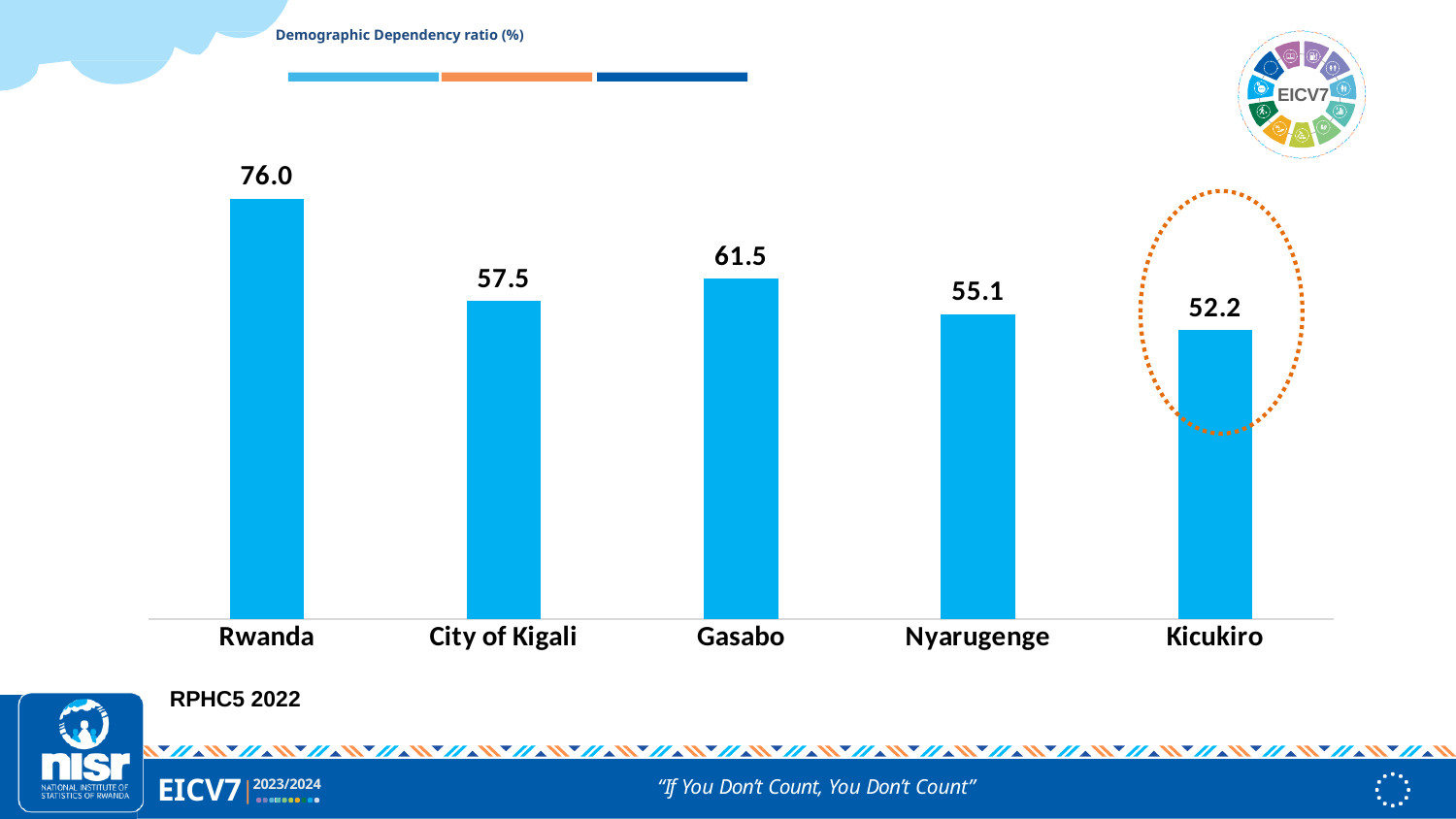
Which has a higher dependency ratio, Gasabo or Nyarugenge? Gasabo What is the demographic dependency ratio for Kicukiro? 52.2 What is the demographic dependency ratio for Nyarugenge? 55.1 What is the difference between the dependency ratio for Gasabo and for Kicukiro? 9.3 What is the difference between the dependency ratio for Rwanda and for City of Kigali? 18.5 Which category has the highest demographic dependency ratio? Rwanda Which category has the lowest demographic dependency ratio? Kicukiro What is the demographic dependency ratio for City of Kigali? 57.5 What is the demographic dependency ratio for Rwanda? 76.0 How many categories are shown in the chart? 5 What kind of chart is shown on the slide? Bar chart What is the demographic dependency ratio for Gasabo? 61.5